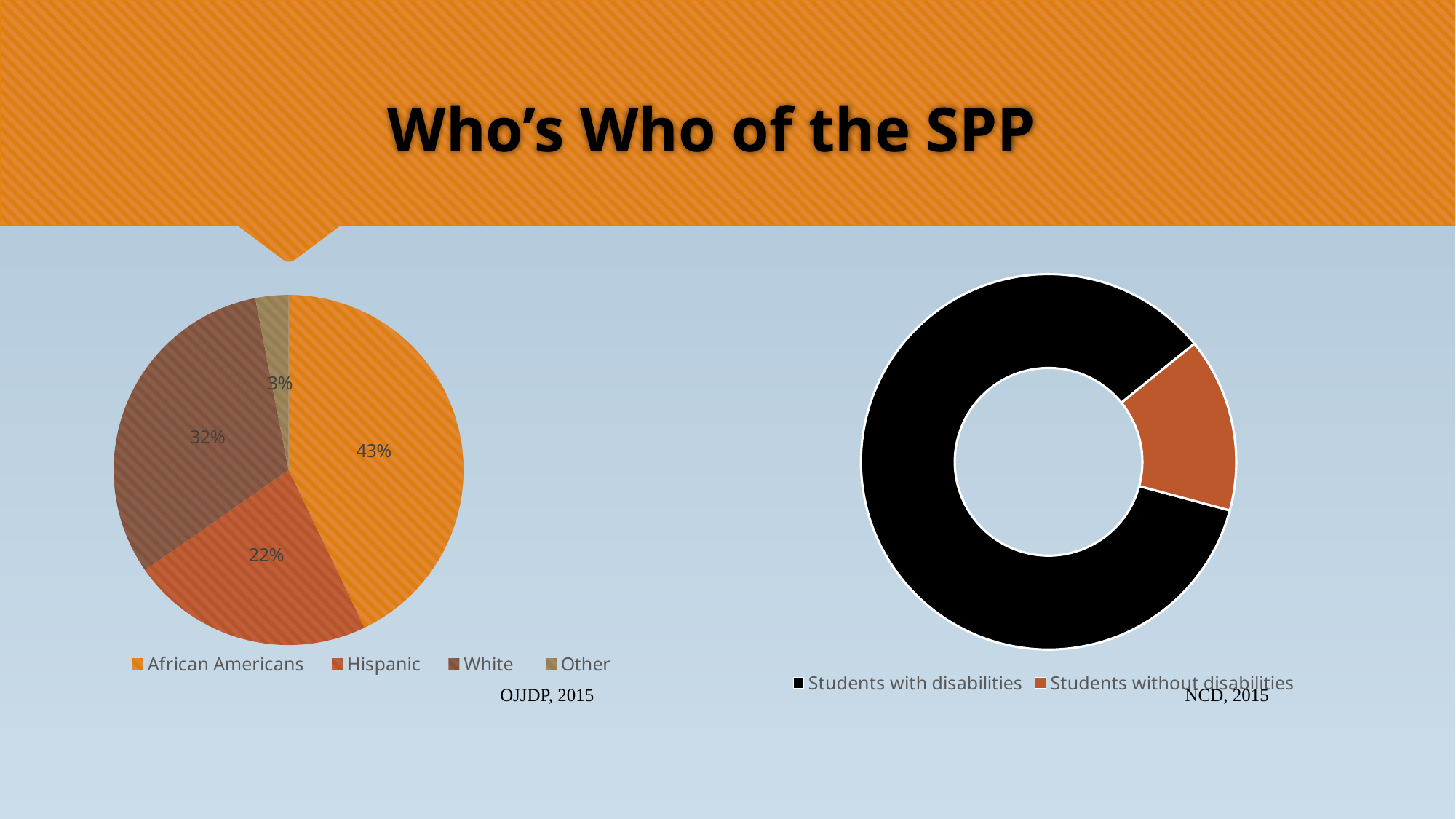
On the left pie chart, what share is labelled for African Americans? 43% On the left pie chart, what share is labelled for Hispanic? 22% How many categories does the left pie chart show? 4 What kind of chart is on the right side of the slide? Doughnut chart On the left pie chart, what share is labelled for White? 32% On the left pie chart, what is the difference in percentage points between the African Americans slice and the White slice? 11 On the left pie chart, which category has the largest slice? African Americans On the left pie chart, what share is labelled for Other? 3% On the left pie chart, which category has the smallest slice? Other On the left pie chart, which slice is larger, Hispanic or White? White On the right doughnut chart, which segment is larger, Students with disabilities or Students without disabilities? Students with disabilities How many entries does the legend of the right doughnut chart list? 2